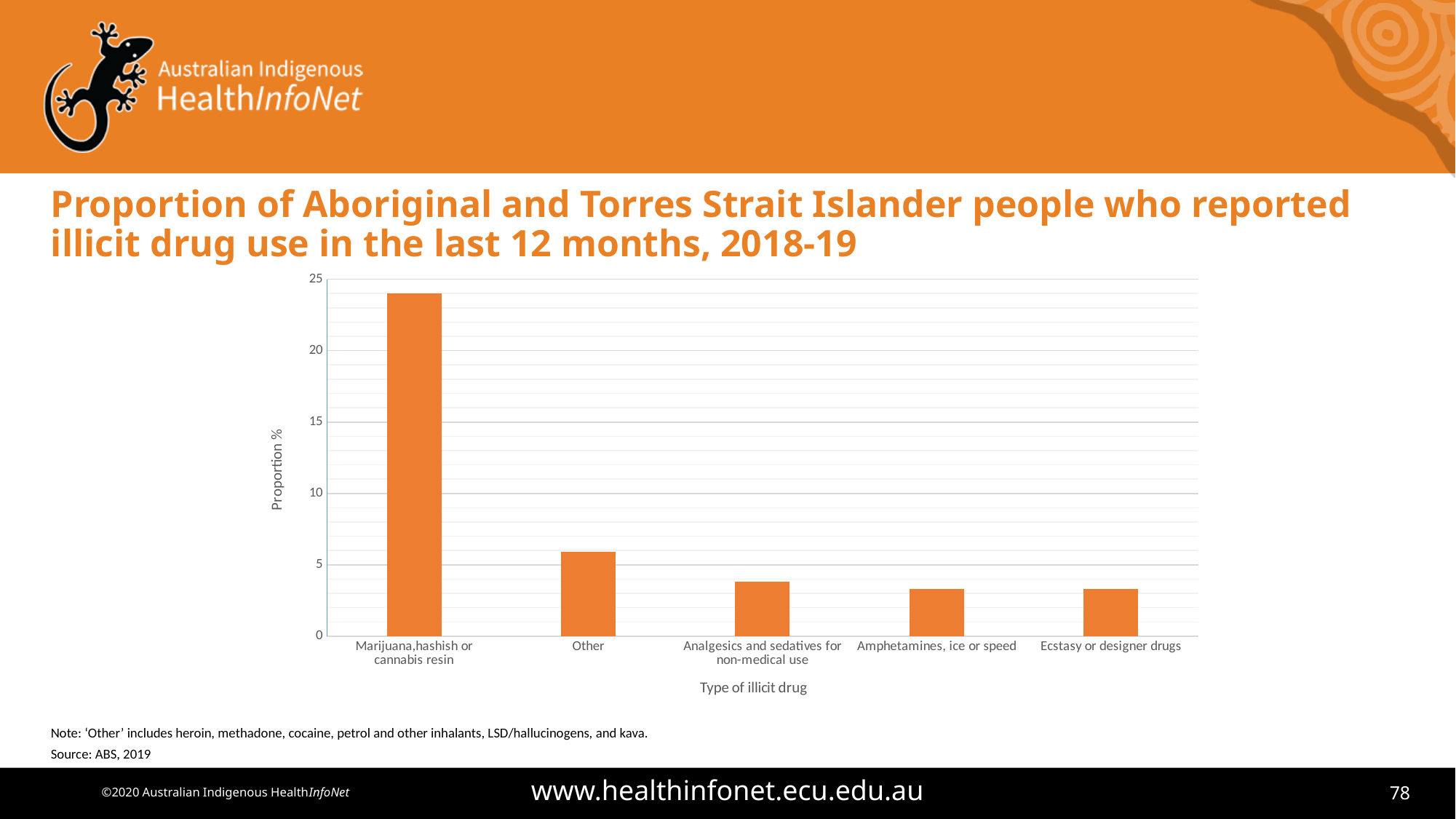
How many types of illicit drug are shown on the x axis of the chart? 5 Is the value for Amphetamines, ice or speed greater or less than 5? less Is the value for Marijuana, hashish or cannabis resin greater or less than 20? greater Is the value for Marijuana, hashish or cannabis resin greater or less than 25? less What is the label on the x axis of the chart? Type of illicit drug What is the label on the y axis of the chart? Proportion % Which type of illicit drug has the highest reported proportion of use? Marijuana, hashish or cannabis resin Which is larger, the value for Other or the value for Analgesics and sedatives for non-medical use? Other What type of chart is shown on the slide? bar chart